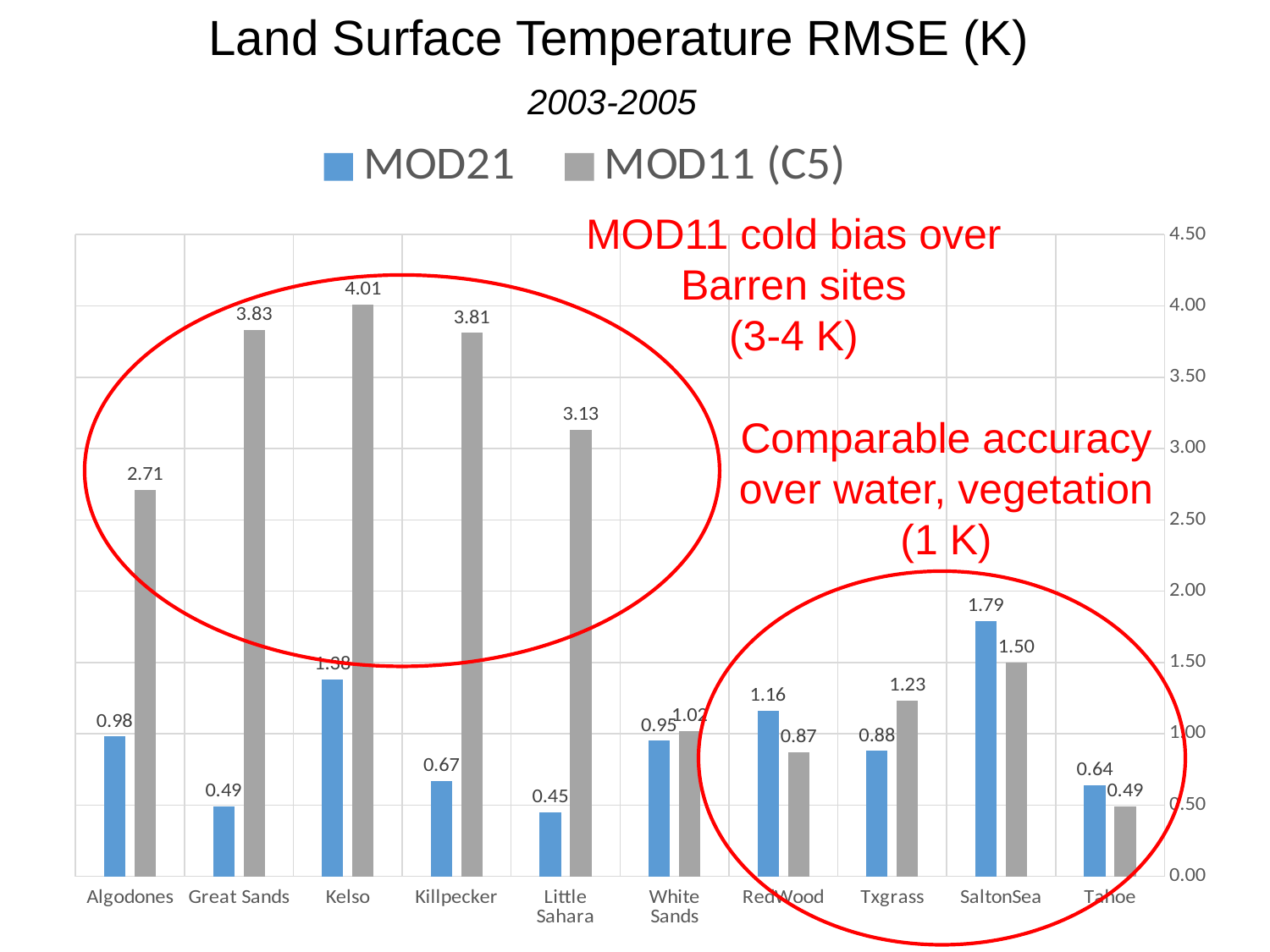
What is the MOD11 (C5) value for Txgrass? 1.23 What is the MOD11 (C5) value for Kelso? 4.01 How many sites are shown on the x axis? 10 Which site has the highest MOD11 (C5) value? Kelso What kind of chart is shown on the slide? bar chart For SaltonSea, which series has the larger value, MOD21 or MOD11 (C5)? MOD21 Is the MOD11 (C5) value for Little Sahara greater or less than 3.00? greater What is the difference between the MOD11 (C5) and MOD21 values for Great Sands? 3.34 What is the MOD21 value for Algodones? 0.98 How many series does the legend list? 2 Which site has the lowest MOD11 (C5) value? Tahoe Which site has the highest MOD21 value? SaltonSea